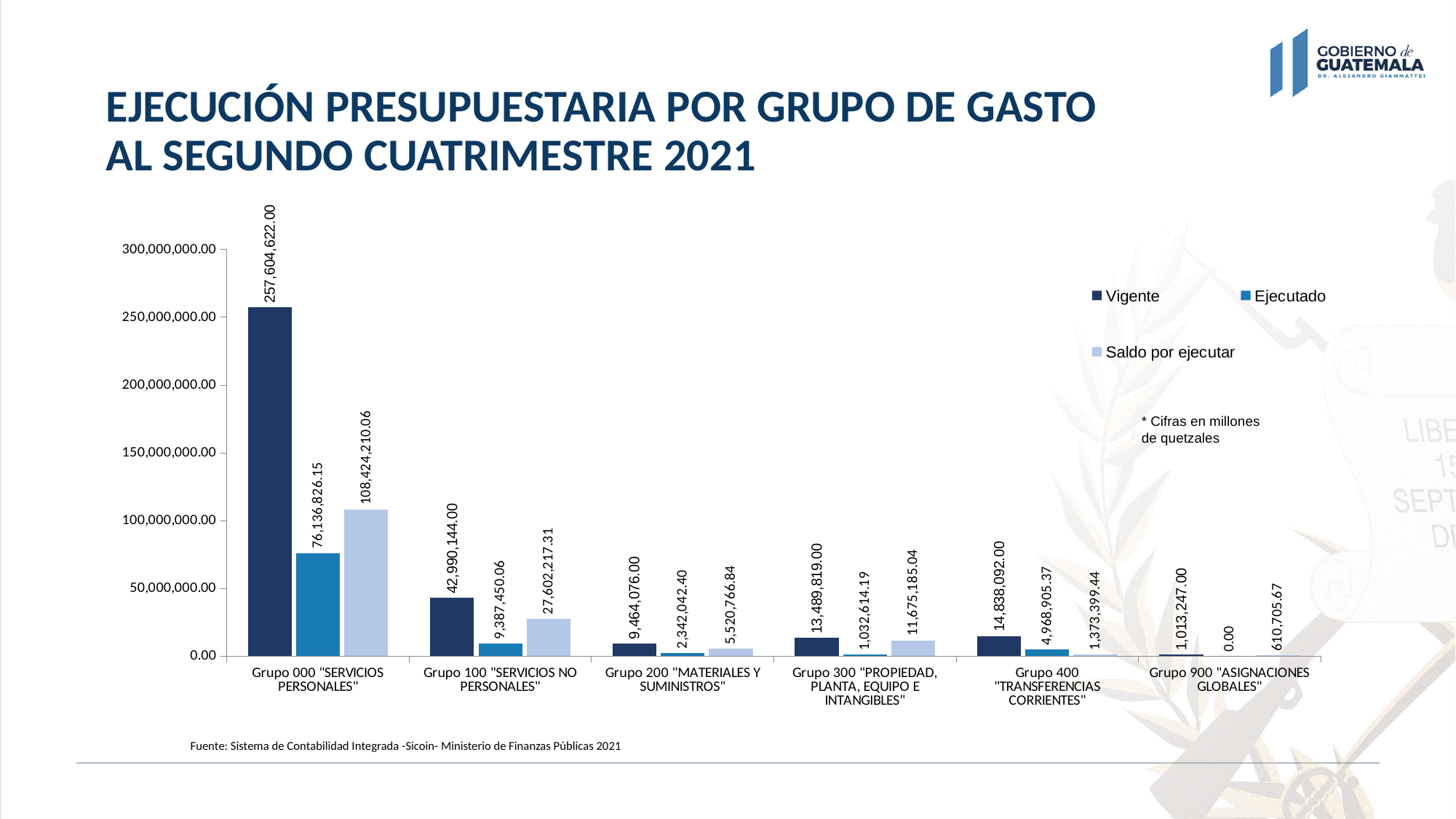
How many expense groups (categories) are shown on the x axis? 6 Which group has the highest Vigente value? Grupo 000 "SERVICIOS PERSONALES" What is the Ejecutado value for Grupo 900 "ASIGNACIONES GLOBALES"? 0.00 How many series does the legend list? 3 What is the Saldo por ejecutar value for Grupo 300 "PROPIEDAD, PLANTA, EQUIPO E INTANGIBLES"? 11,675,185.04 Which is larger for Grupo 400 "TRANSFERENCIAS CORRIENTES": the Ejecutado value or the Saldo por ejecutar value? Ejecutado What is the Vigente value for Grupo 000 "SERVICIOS PERSONALES"? 257,604,622.00 What is the difference between the Vigente and Ejecutado values for Grupo 000 "SERVICIOS PERSONALES"? 181,467,795.85 What is the Ejecutado value for Grupo 100 "SERVICIOS NO PERSONALES"? 9,387,450.06 Is the Saldo por ejecutar value for Grupo 000 "SERVICIOS PERSONALES" greater or less than 100,000,000.00? greater What type of chart is shown on the slide? bar chart Which group has the lowest Vigente value? Grupo 900 "ASIGNACIONES GLOBALES"